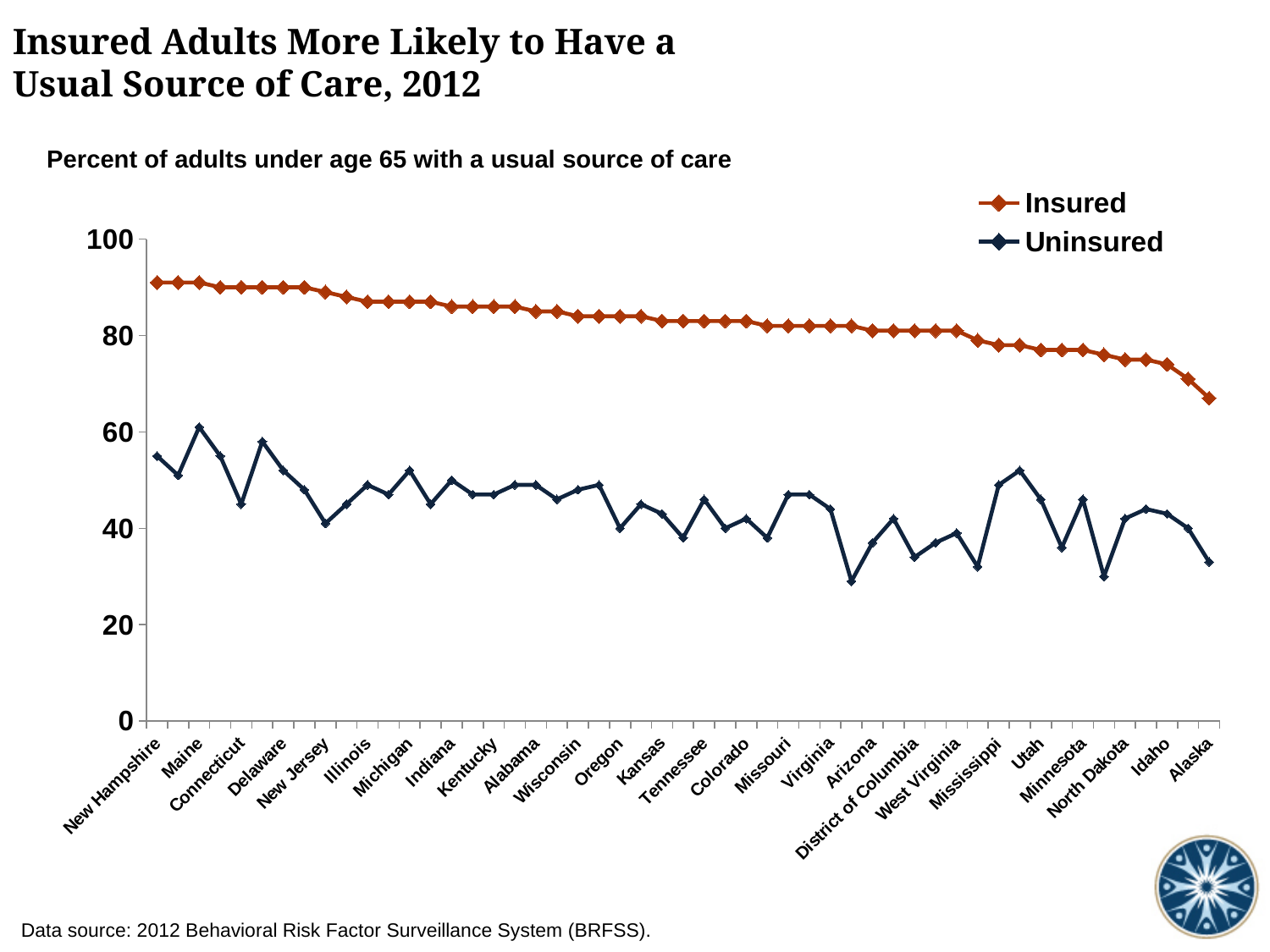
Do the Insured values rise or fall moving from New Hampshire to Alaska along the x axis? fall What kind of chart is shown on the slide? line chart Which series has the lower values across all states, Insured or Uninsured? Uninsured What colour is the line for the Insured series? orange Is the Uninsured value for Arizona greater or less than 40? less Which state has the lowest Insured value? Alaska Is the Insured value for New Hampshire greater or less than 80? greater How many series does the legend list? 2 Which state has the highest Uninsured value? Maine Is the Insured value for Mississippi greater or less than 60? greater